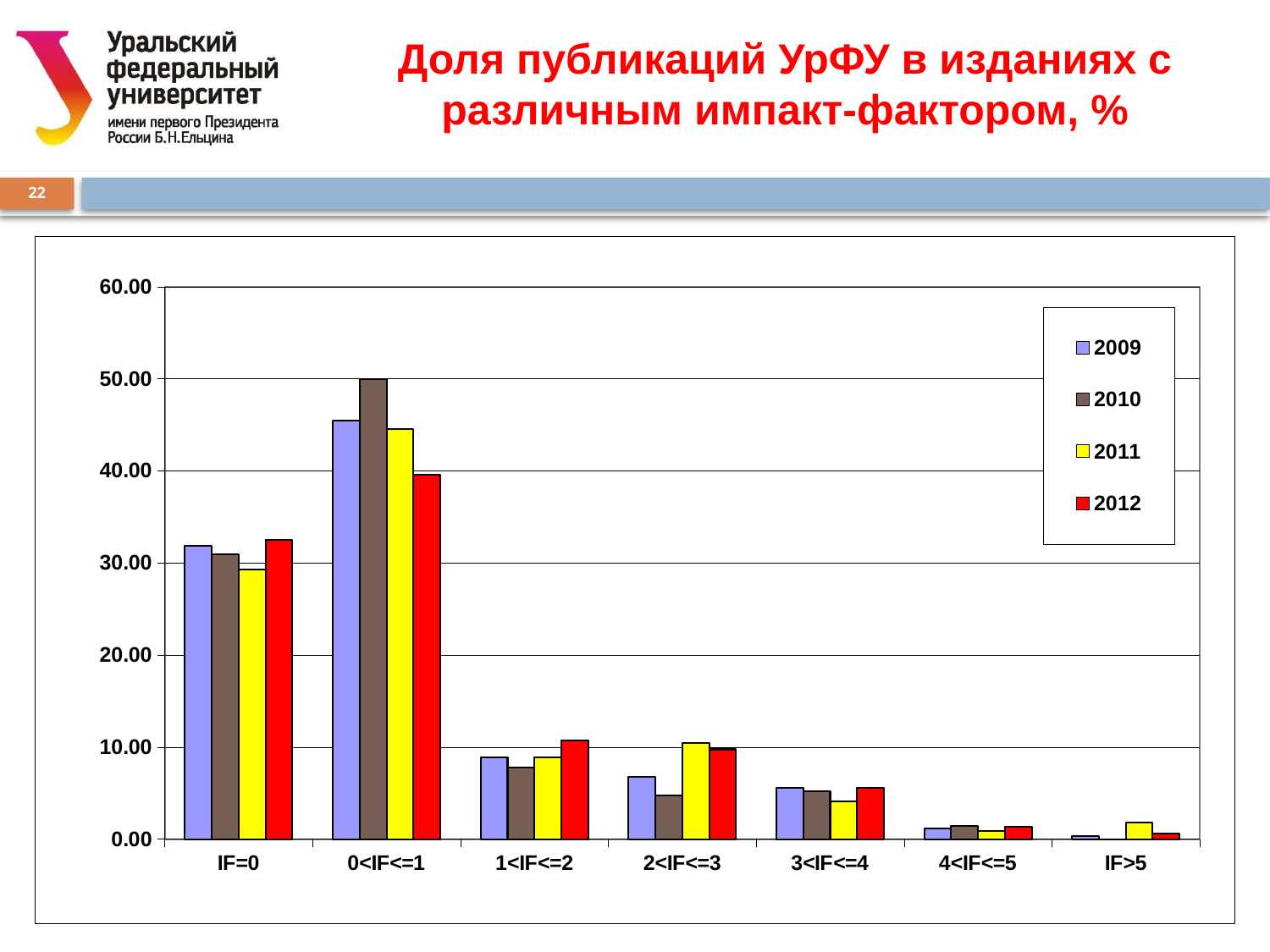
Is the value for 2009 in the IF=0 category greater or less than 30.00? greater In the 2<IF<=3 category, which is larger: the value for 2011 or for 2010? 2011 How many series does the legend list? 4 How many impact-factor categories are shown on the x axis? 7 Which category has the lowest value for 2012? IF>5 What colour represents the 2012 series in the chart? red Which category has the highest value for 2010? 0<IF<=1 Do the 2012 values rise or fall along the x axis from 1<IF<=2 to IF>5? fall Is the value for 2010 in the 0<IF<=1 category greater or less than 40.00? greater Is the value for 2012 in the 0<IF<=1 category greater or less than 30.00? greater In the 0<IF<=1 category, which is larger: the value for 2010 or for 2012? 2010 What kind of chart is shown on the slide? bar chart